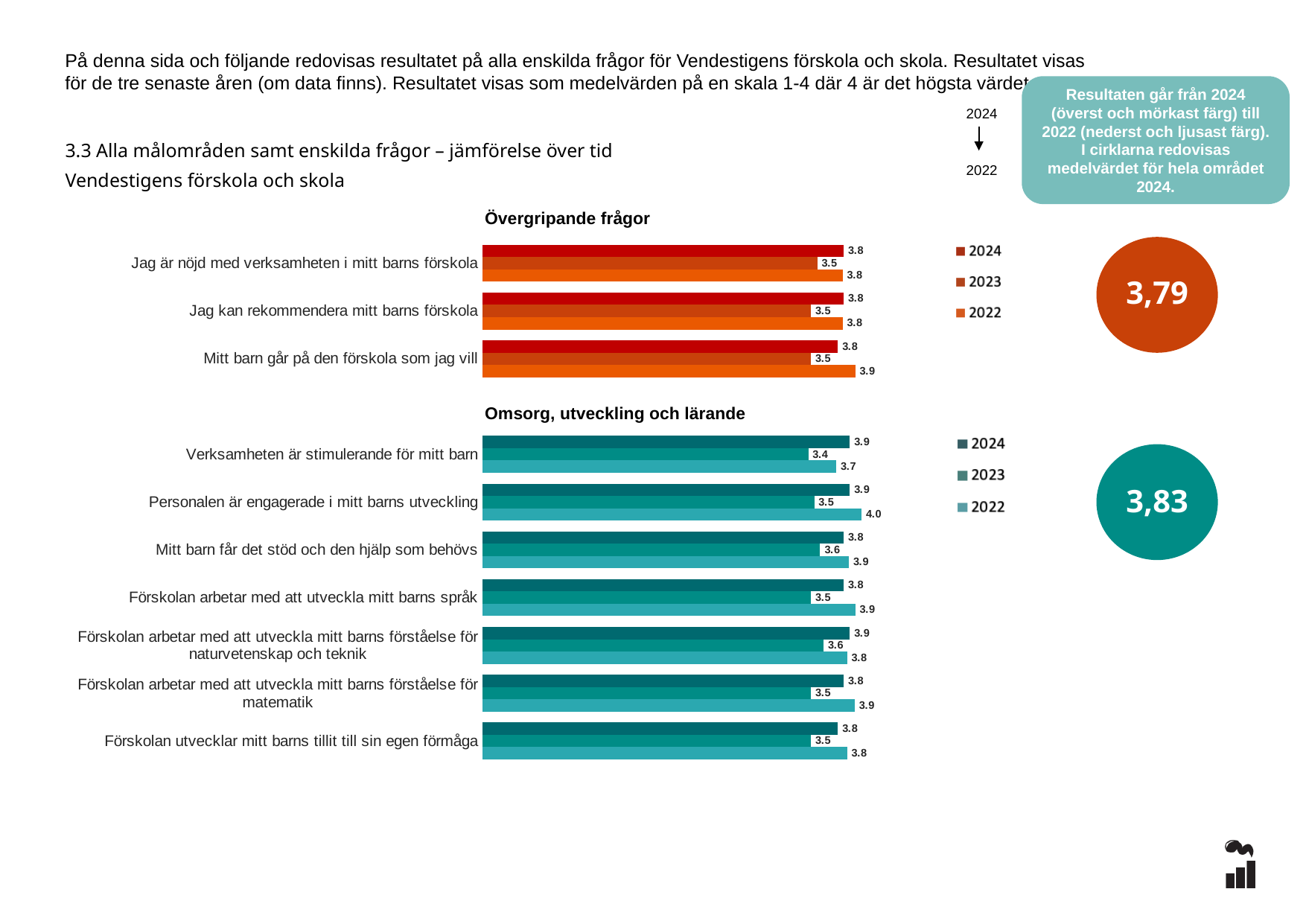
In the 'Omsorg, utveckling och lärande' chart, which category has the lowest 2023 value? Verksamheten är stimulerande för mitt barn In the 'Övergripande frågor' chart, what is the 2023 value for 'Jag är nöjd med verksamheten i mitt barns förskola'? 3.5 What kind of chart is the 'Övergripande frågor' chart? Bar chart In the 'Övergripande frågor' chart, how many series does the legend list? 3 In the 'Övergripande frågor' chart, what is the 2022 value for 'Mitt barn går på den förskola som jag vill'? 3.9 In the 'Omsorg, utveckling och lärande' chart, how many categories are shown? 7 In the 'Omsorg, utveckling och lärande' chart, what is the difference between the 2022 and 2023 values for 'Personalen är engagerade i mitt barns utveckling'? 0.5 In the 'Omsorg, utveckling och lärande' chart, which is larger for 'Mitt barn får det stöd och den hjälp som behövs': the 2024 value or the 2022 value? 2022 In the 'Omsorg, utveckling och lärande' chart, what is the 2023 value for 'Verksamheten är stimulerande för mitt barn'? 3.4 What is the overall mean value shown in the circle next to the 'Omsorg, utveckling och lärande' chart? 3,83 In the 'Omsorg, utveckling och lärande' chart, what is the 2022 value for 'Personalen är engagerade i mitt barns utveckling'? 4.0 In the 'Övergripande frågor' chart, how many categories are shown? 3